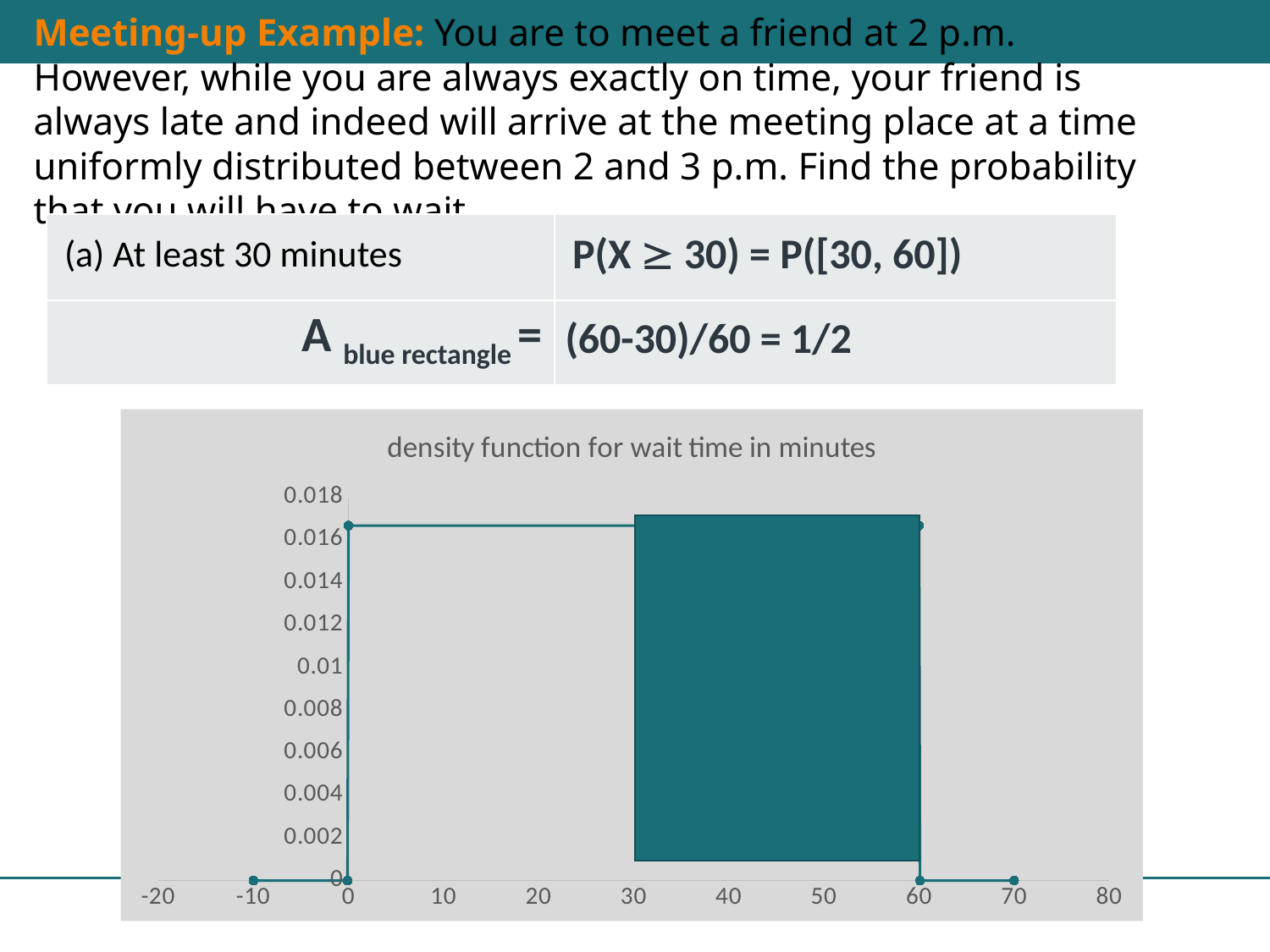
What kind of chart is shown on the slide? line chart Is the density value at x = 20 greater or less than 0.014? greater What is the lowest tick value shown on the x axis? -20 What is the highest tick value shown on the y axis? 0.018 Is the density value at x = -10 greater or less than 0.004? less Is the density value at x = 70 greater or less than 0.002? less How many tick labels are shown on the x axis? 11 Between which two x-axis values does the shaded rectangle extend? 30 and 60 Does the density value rise or fall as x goes from 60 to 70? falls Does the density value rise, fall, or stay flat as x goes from 10 to 50? stays flat What is the title of the chart? density function for wait time in minutes